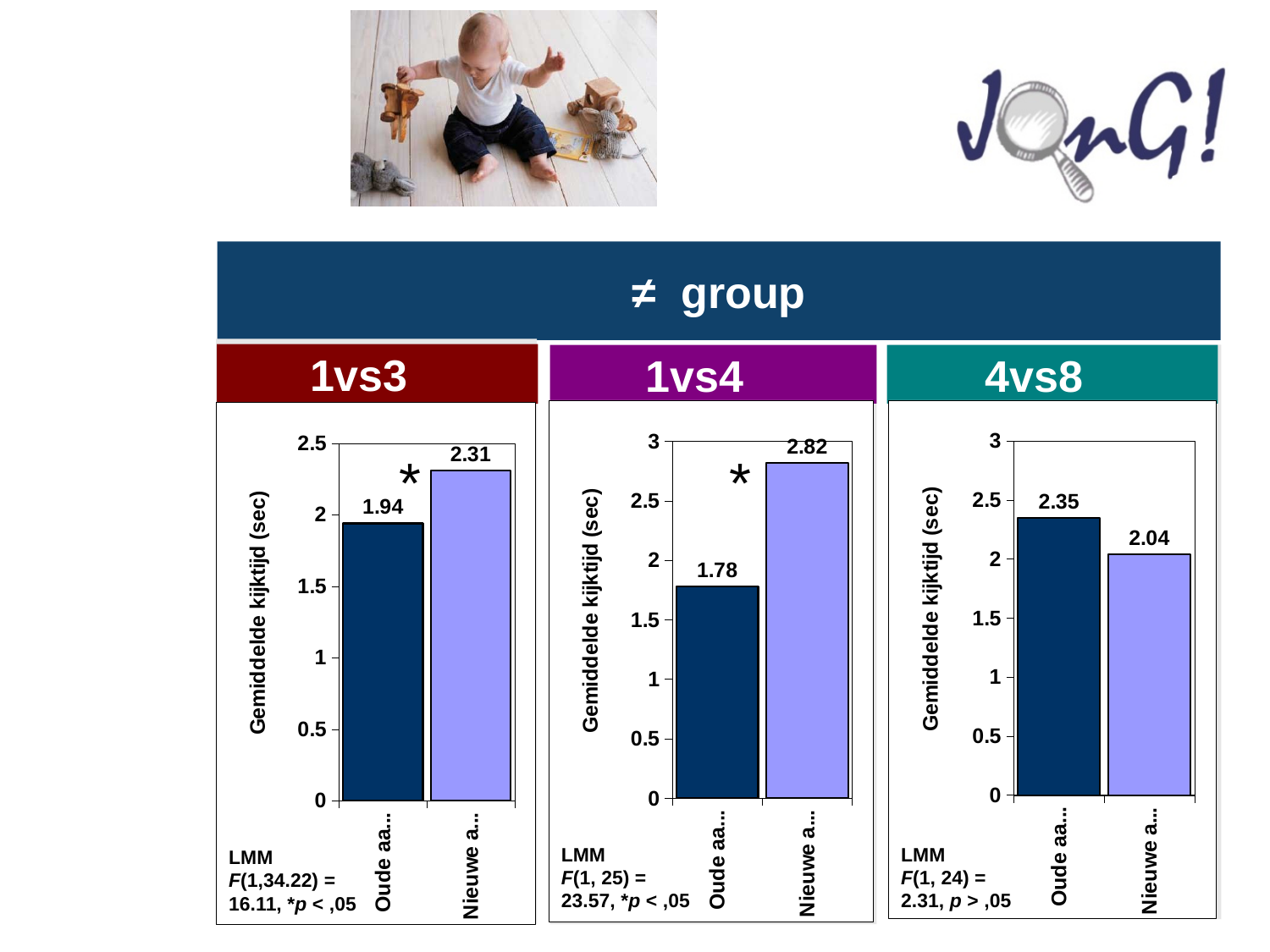
In the 1vs4 chart, is the value of the left bar (Oude aa...) greater or less than 2? less What type of chart is the 4vs8 chart? bar chart In the 1vs3 chart, what is the value of the right bar (Nieuwe a...)? 2.31 In the 4vs8 chart, what is the difference between the two bars? 0.31 In the 4vs8 chart, what is the value of the left bar (Oude aa...)? 2.35 In the 1vs4 chart, what is the difference between the two bars? 1.04 In the 4vs8 chart, which bar is higher, the left (Oude aa...) or the right (Nieuwe a...)? the left (Oude aa...) In the 1vs3 chart, what is the value of the left bar (Oude aa...)? 1.94 In the 1vs3 chart, which bar is the lowest? the left bar (Oude aa...) In the 1vs4 chart, what is the value of the right bar (Nieuwe a...)? 2.82 How many bars does the 1vs4 chart have? 2 What is the y-axis label of the 1vs3 chart? Gemiddelde kijktijd (sec)